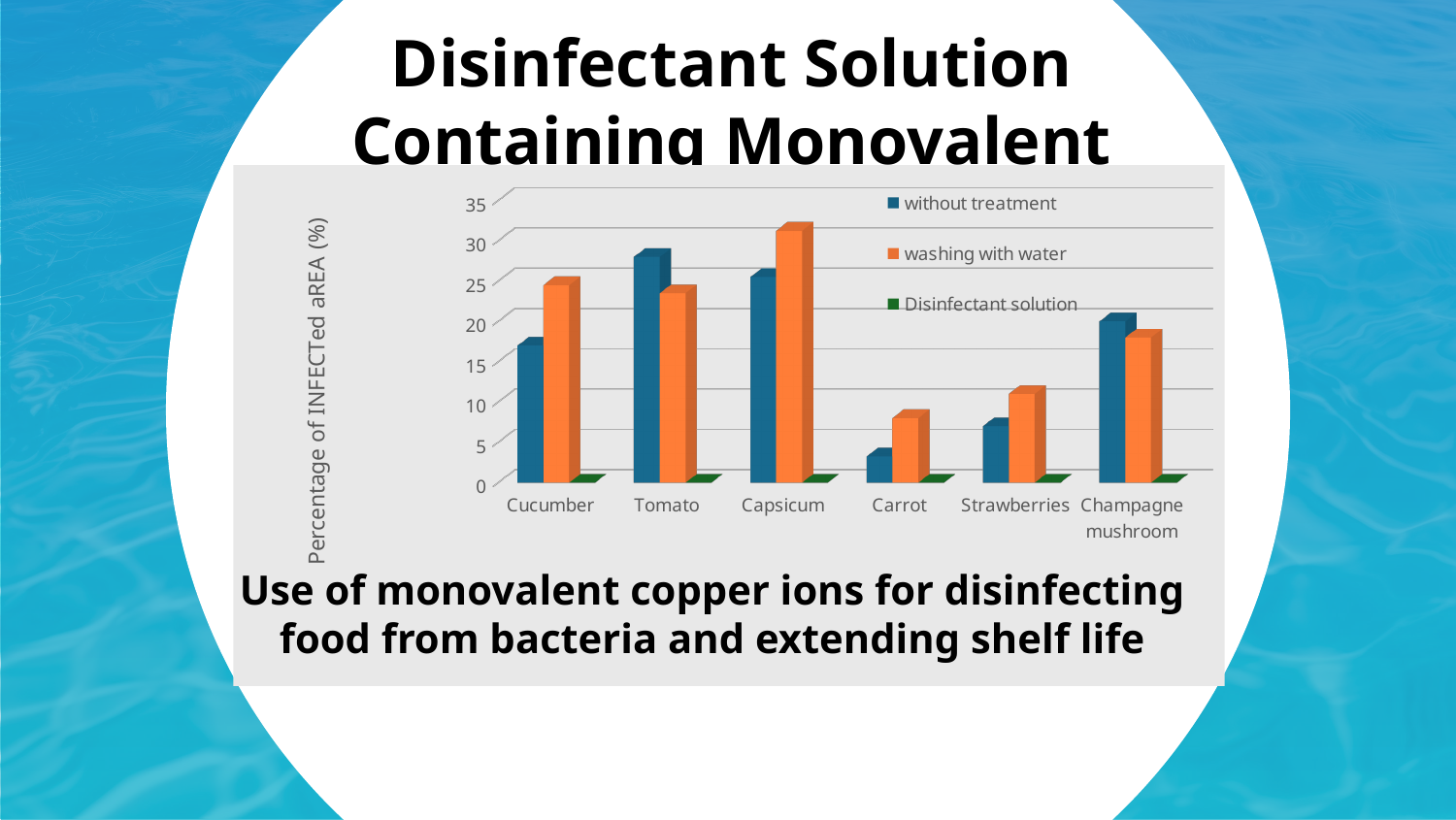
Is the 'washing with water' value for Carrot greater or less than 10? less Is the 'Disinfectant solution' value for Capsicum greater or less than 5? less Which category has the highest 'washing with water' bar? Capsicum What is the label of the y axis of the chart? Percentage of INFECTed aREA (%) For Cucumber, which is larger: the 'without treatment' value or the 'washing with water' value? washing with water Is the 'without treatment' value for Cucumber greater or less than 15? greater What kind of chart is shown on the slide? Bar chart How many series does the chart's legend list? 3 For Tomato, which is larger: the 'without treatment' value or the 'washing with water' value? without treatment How many food categories are shown on the x axis of the chart? 6 Which series is shown in orange in the chart? washing with water Which category has the lowest 'without treatment' bar? Carrot